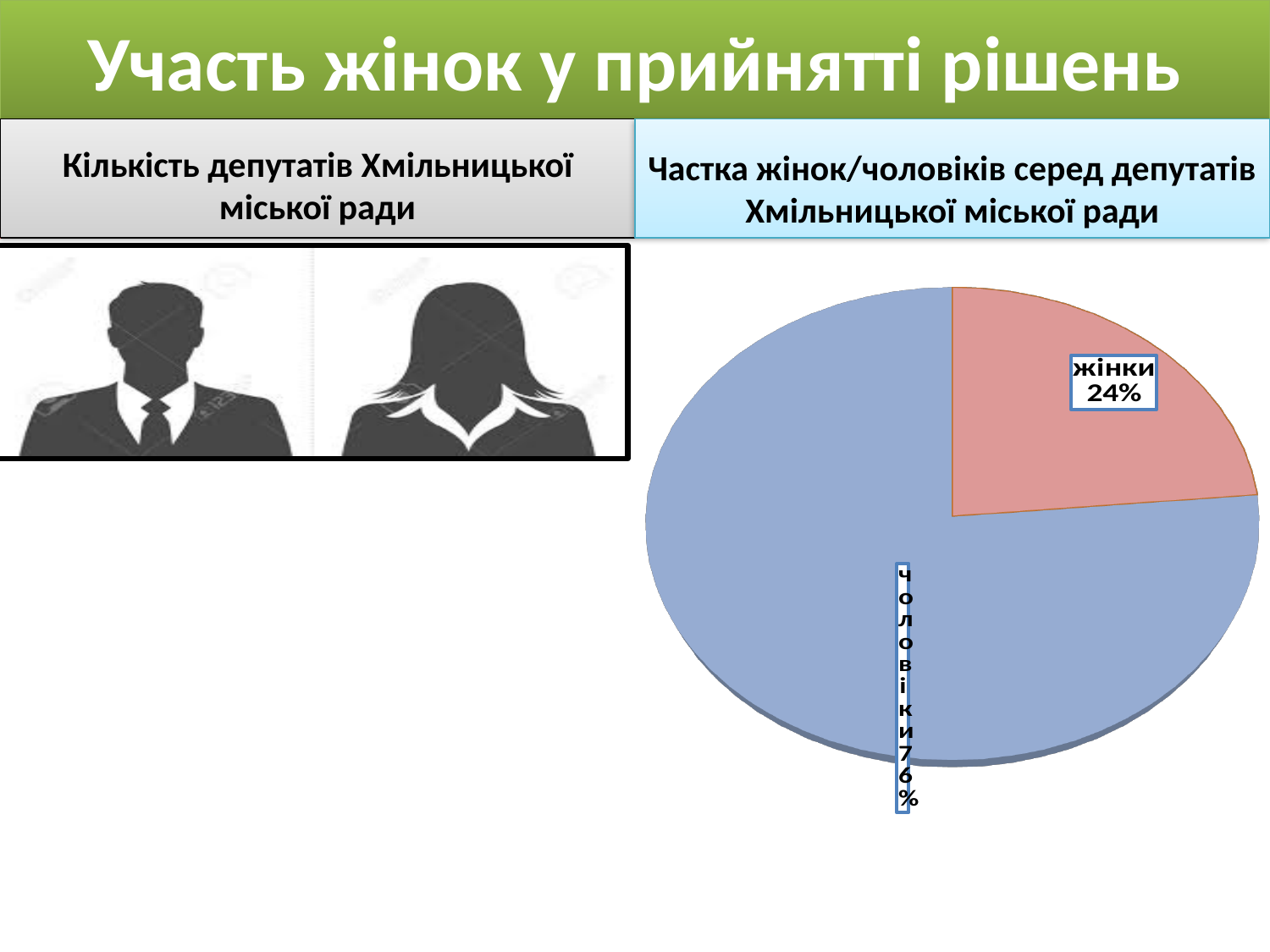
What share of the pie chart is labelled "чоловіки"? 76% What kind of chart is shown on the right side of the slide? pie chart What is the title above the pie chart? Частка жінок/чоловіків серед депутатів Хмільницької міської ради Is the share for "жінки" greater or less than 50%? less Which slice of the pie chart is the largest? чоловіки What share of the pie chart is labelled "жінки"? 24% Which slice of the pie chart is the smallest? жінки What colour is the "жінки" slice of the pie chart? pink Which slice is larger, "жінки" or "чоловіки"? чоловіки How many slices does the pie chart have? 2 What is the difference in percentage points between the "чоловіки" and "жінки" slices? 52